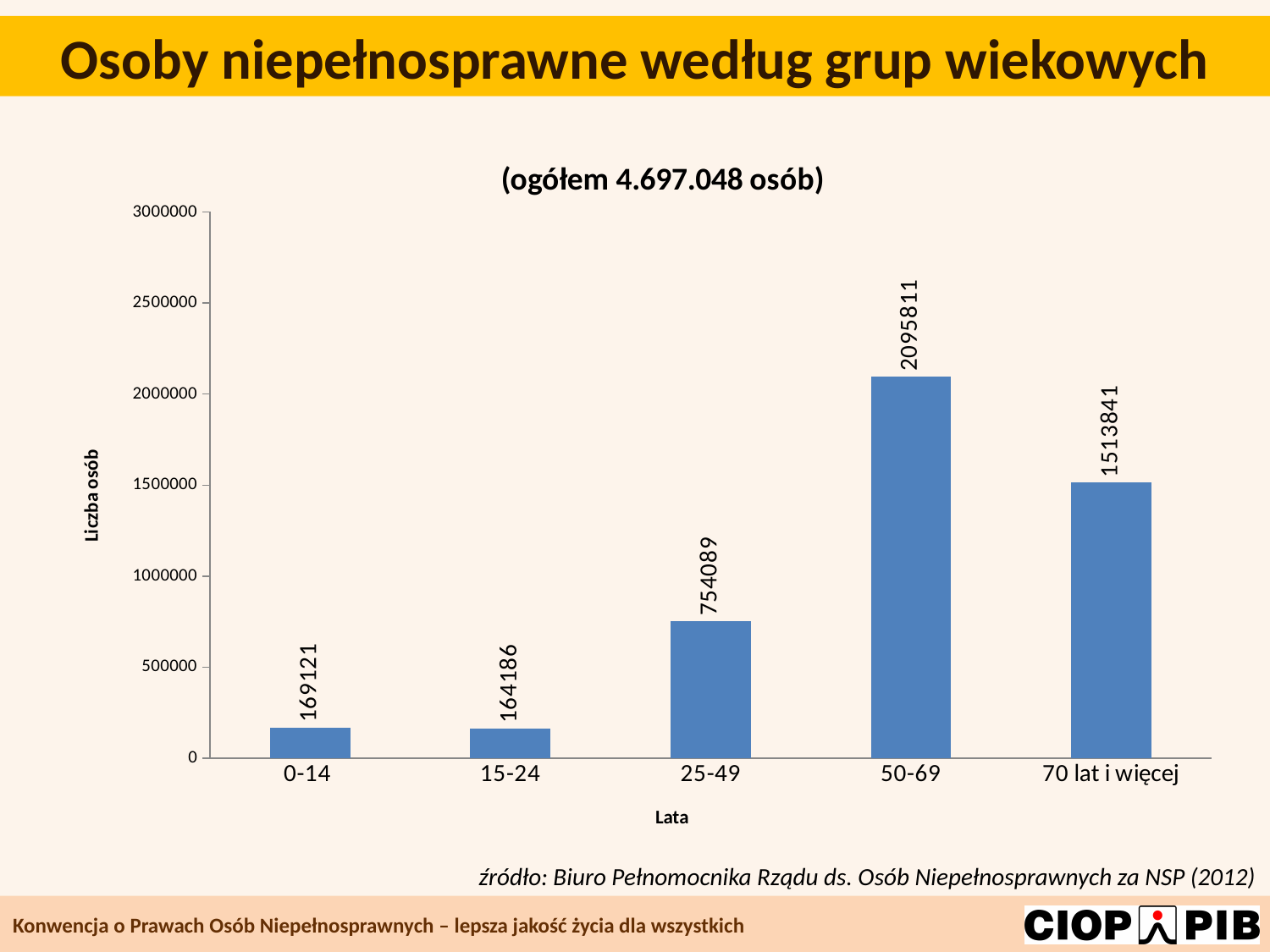
What is the label of the y axis? Liczba osób What kind of chart is shown on the slide? bar chart Is the value for 25-49 greater or less than 1000000? less How many age groups are shown on the x axis? 5 Which is larger, the value for 25-49 or the value for 70 lat i więcej? 70 lat i więcej Which age group has the lowest value? 15-24 What is the difference between the values for 50-69 and 70 lat i więcej? 581970 Which age group has the highest value? 50-69 What is the value for the 70 lat i więcej category? 1513841 What is the value for the 50-69 age group? 2095811 What is the difference between the values for 0-14 and 15-24? 4935 What is the value for the 0-14 age group? 169121